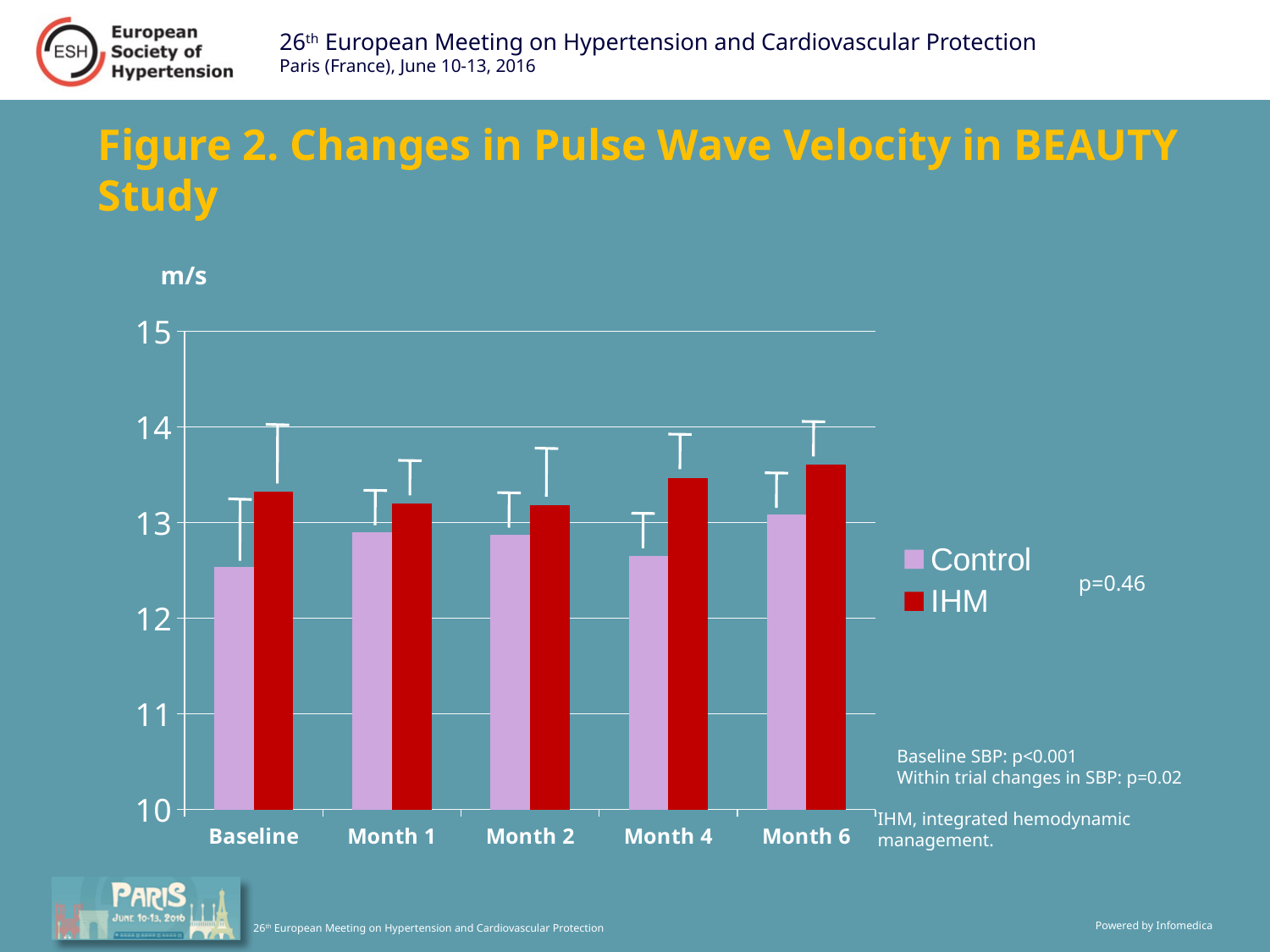
What kind of chart is shown on the slide? bar chart How many time points (categories) are shown on the x axis? 5 What unit is shown on the y axis? m/s At which time point is the IHM bar highest? Month 6 Is the Control value at Baseline greater or less than 13? less Is the IHM value at Baseline greater or less than 14? less How many series does the legend list? 2 Is the IHM value at Month 6 greater or less than 13? greater At which time point is the Control bar highest? Month 6 Which colour represents the IHM series? red At Baseline, which is larger, the Control bar or the IHM bar? IHM